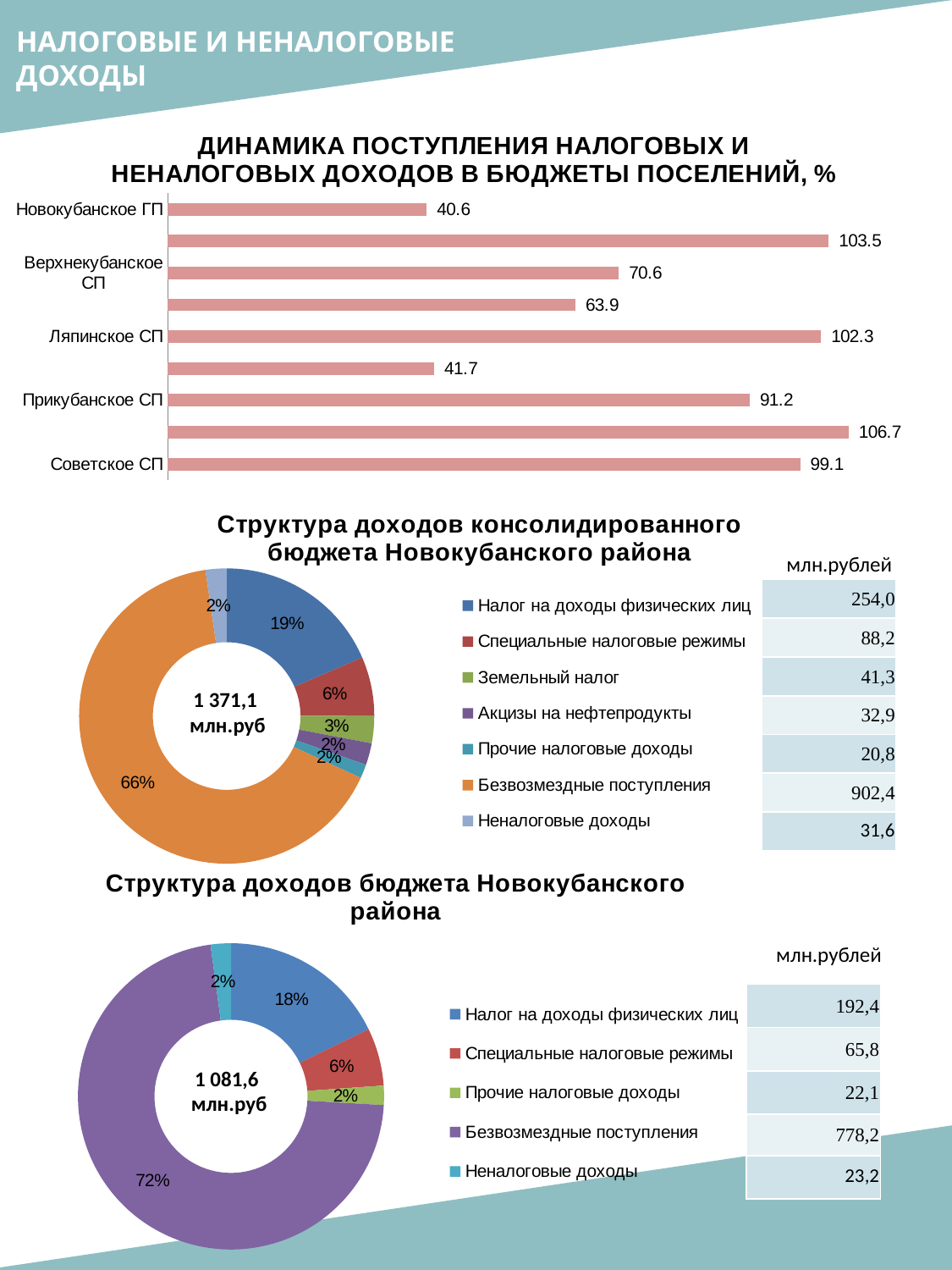
In the chart 'Структура доходов бюджета Новокубанского района', what is the value in млн.рублей for 'Специальные налоговые режимы'? 65,8 What type of chart is the top chart titled 'ДИНАМИКА ПОСТУПЛЕНИЯ НАЛОГОВЫХ И НЕНАЛОГОВЫХ ДОХОДОВ В БЮДЖЕТЫ ПОСЕЛЕНИЙ, %'? bar chart How many categories does the legend list for the chart 'Структура доходов консолидированного бюджета Новокубанского района'? 7 In the top bar chart, what is the highest value shown? 106.7 In the top bar chart, what is the difference between the highest value (106.7) and the lowest value (40.6)? 66.1 In the chart 'Структура доходов консолидированного бюджета Новокубанского района', what is the value in млн.рублей for 'Налог на доходы физических лиц'? 254,0 In the top bar chart, what is the lowest value shown? 40.6 How many bars are plotted in the top bar chart? 9 What total is shown in the centre of the donut chart 'Структура доходов консолидированного бюджета Новокубанского района'? 1 371,1 млн.руб In the chart 'Структура доходов консолидированного бюджета Новокубанского района', what share does 'Безвозмездные поступления' have? 66% In the chart 'Структура доходов бюджета Новокубанского района', what share does 'Безвозмездные поступления' have? 72% In the chart 'Структура доходов бюджета Новокубанского района', which is larger: 'Налог на доходы физических лиц' or 'Неналоговые доходы'? Налог на доходы физических лиц